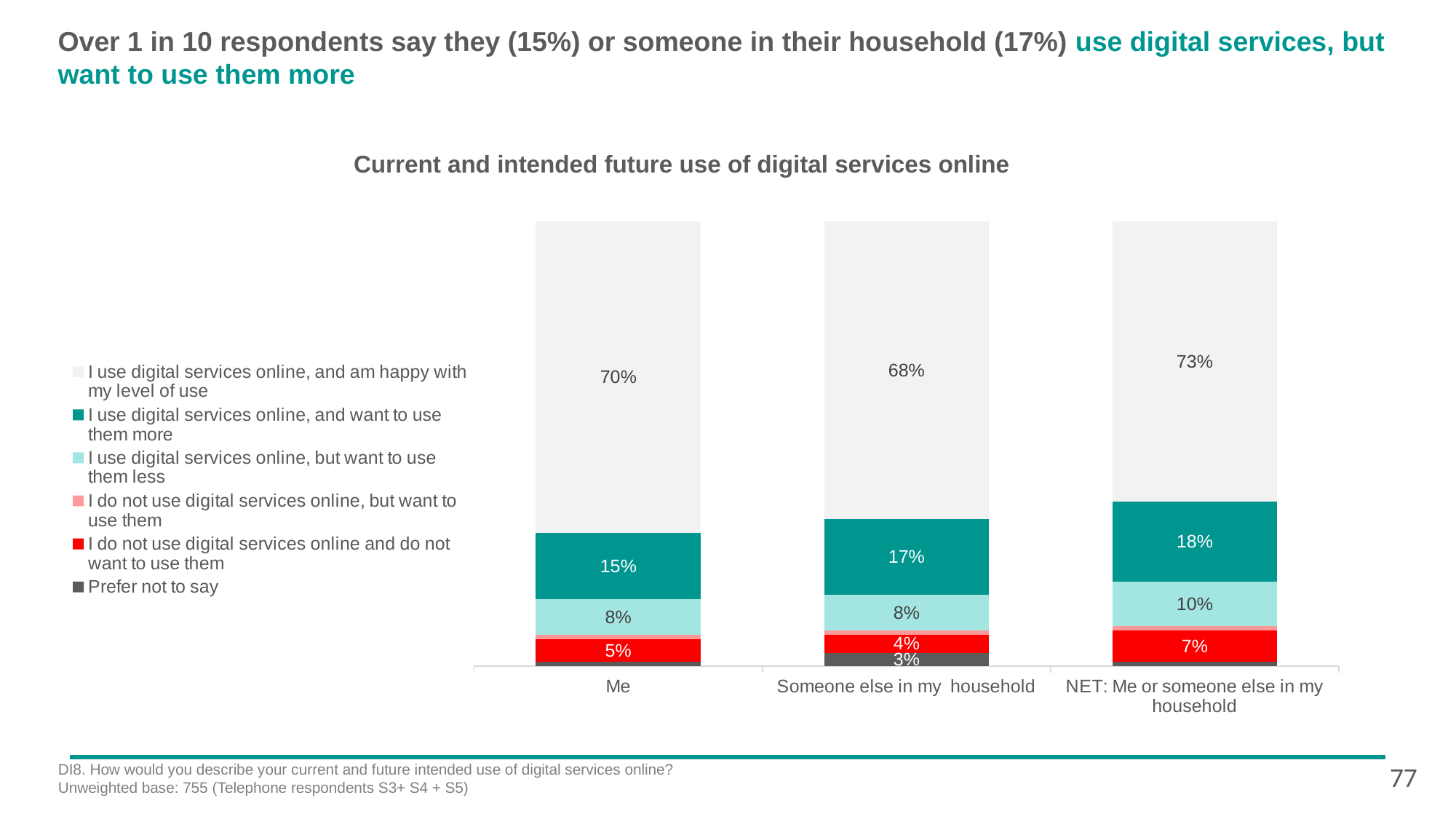
How many series does the legend list? 6 Which is larger: the 'I do not use digital services online and do not want to use them' value for 'Me' or for 'Someone else in my household'? Me What kind of chart is shown on the slide? Stacked bar chart What is the difference between the 'I use digital services online, and want to use them more' values for 'NET: Me or someone else in my household' and 'Me'? 3% What is the value for 'I use digital services online, and want to use them more' in the 'Someone else in my household' bar? 17% What is the title of the chart? Current and intended future use of digital services online What is the value for 'I use digital services online, but want to use them less' in the 'NET: Me or someone else in my household' bar? 10% What is the value for 'I do not use digital services online and do not want to use them' in the 'Me' bar? 5% What percentage of the 'Me' bar is 'I use digital services online, and am happy with my level of use'? 70% Which category has the highest value for 'I use digital services online, and am happy with my level of use'? NET: Me or someone else in my household How many categories are shown along the x axis? 3 What is the value for 'Prefer not to say' in the 'Someone else in my household' bar? 3%